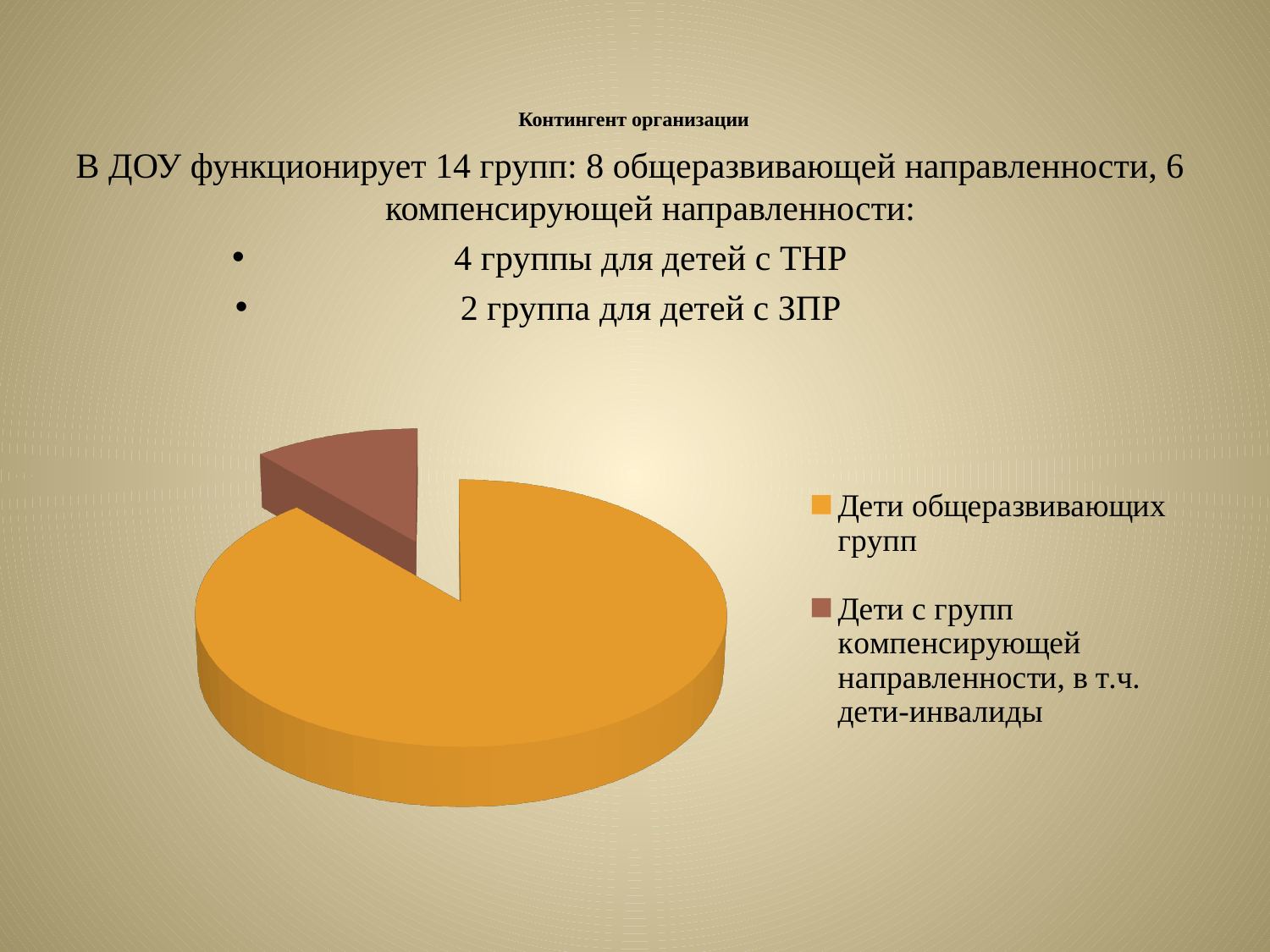
What colour is the slice for "Дети общеразвивающих групп" in the pie chart? orange How many entries does the legend of the pie chart list? 2 Which slice is larger: "Дети общеразвивающих групп" or "Дети с групп компенсирующей направленности, в т.ч. дети-инвалиды"? Дети общеразвивающих групп How many slices does the pie chart have? 2 What kind of chart is shown on the slide? pie chart Which category has the smallest slice in the pie chart? Дети с групп компенсирующей направленности, в т.ч. дети-инвалиды What colour is the slice for "Дети с групп компенсирующей направленности, в т.ч. дети-инвалиды" in the pie chart? brown Which category has the largest slice in the pie chart? Дети общеразвивающих групп